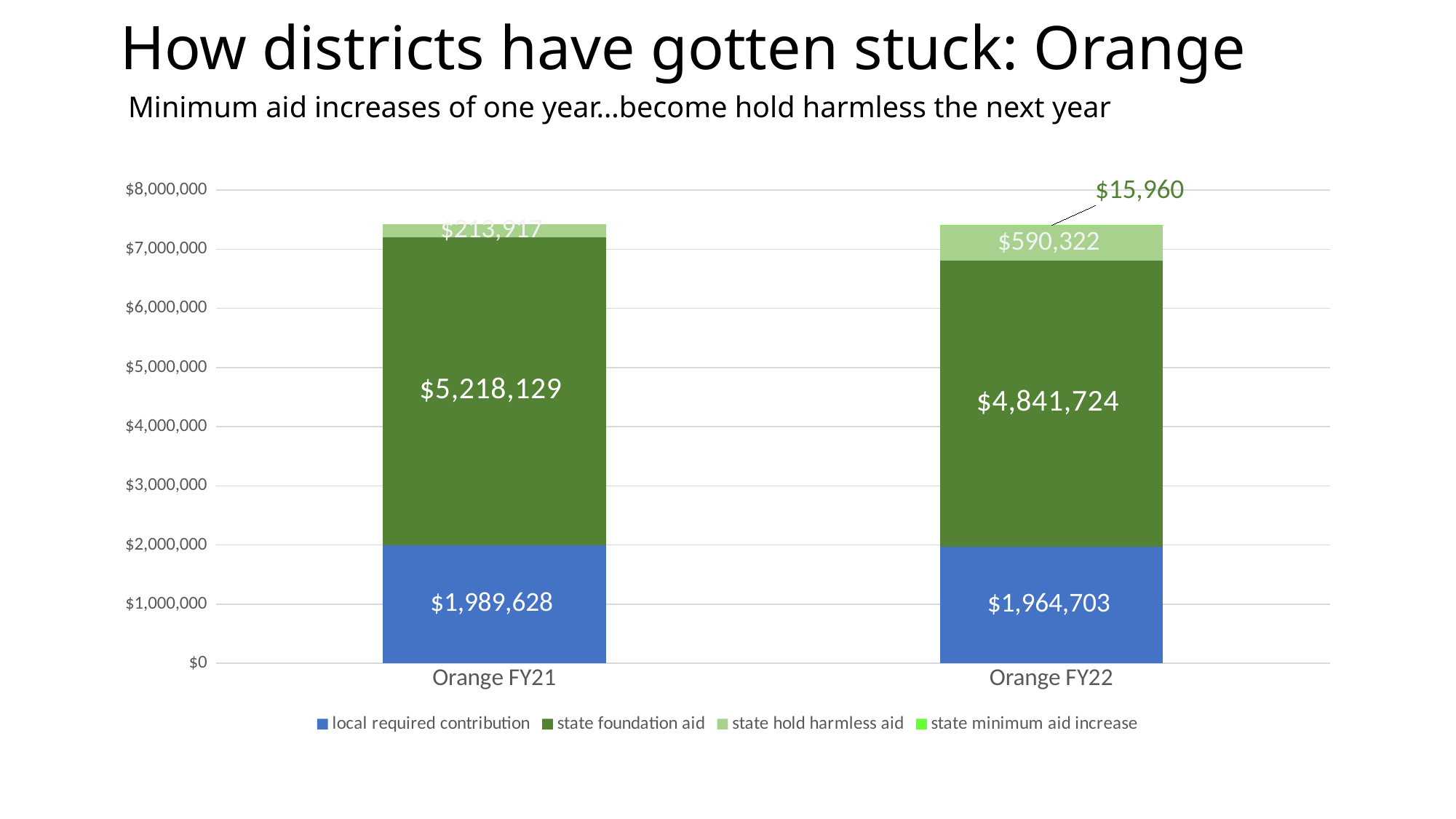
What is the state minimum aid increase for Orange FY22? $15,960 What is the difference in local required contribution between Orange FY21 and Orange FY22? $24,925 What is the local required contribution for Orange FY22? $1,964,703 What is the state hold harmless aid value for Orange FY22? $590,322 What is the state foundation aid value for Orange FY21? $5,218,129 Which year has the larger state foundation aid, Orange FY21 or Orange FY22? Orange FY21 How many categories are plotted on the x axis? 2 What kind of chart is shown on the slide? Stacked bar chart What is the difference in state foundation aid between Orange FY21 and Orange FY22? $376,405 What is the total of the stacked bar for Orange FY22? $7,412,709 Is the total of the Orange FY21 bar greater or less than $7,000,000? greater How many series does the legend list? 4